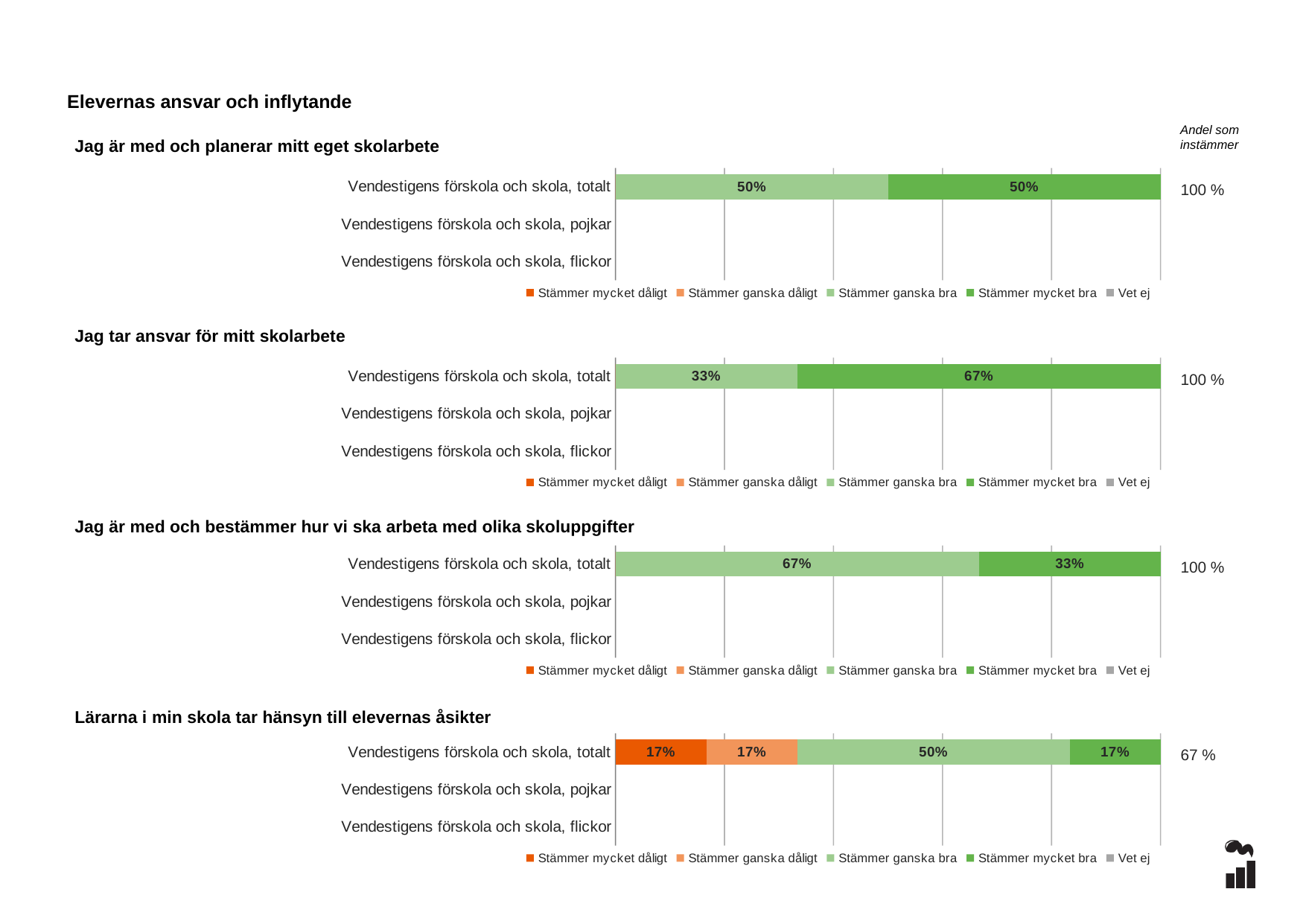
How many series does the legend list in the chart 'Jag tar ansvar för mitt skolarbete'? 5 In the chart 'Lärarna i min skola tar hänsyn till elevernas åsikter', which response category has the largest share for Vendestigens förskola och skola, totalt? Stämmer ganska bra In the chart 'Lärarna i min skola tar hänsyn till elevernas åsikter', what is the value for 'Stämmer mycket dåligt' for Vendestigens förskola och skola, totalt? 17% What is the 'Andel som instämmer' value shown for the chart 'Lärarna i min skola tar hänsyn till elevernas åsikter'? 67 % In the chart 'Lärarna i min skola tar hänsyn till elevernas åsikter', what is the total of 'Stämmer mycket dåligt' and 'Stämmer ganska dåligt' for Vendestigens förskola och skola, totalt? 34% In the chart 'Jag tar ansvar för mitt skolarbete', what is the value for 'Stämmer mycket bra' for Vendestigens förskola och skola, totalt? 67% What kind of chart is 'Lärarna i min skola tar hänsyn till elevernas åsikter'? Stacked bar chart In the chart 'Jag tar ansvar för mitt skolarbete', what is the difference between 'Stämmer mycket bra' and 'Stämmer ganska bra' for Vendestigens förskola och skola, totalt? 34% In the chart 'Jag är med och bestämmer hur vi ska arbeta med olika skoluppgifter', which is larger for Vendestigens förskola och skola, totalt: 'Stämmer ganska bra' or 'Stämmer mycket bra'? Stämmer ganska bra How many categories are listed on the y axis of the chart 'Jag är med och planerar mitt eget skolarbete'? 3 In the chart 'Jag är med och bestämmer hur vi ska arbeta med olika skoluppgifter', what is the value for 'Stämmer ganska bra' for Vendestigens förskola och skola, totalt? 67% In the chart 'Jag är med och planerar mitt eget skolarbete', what is the value for 'Stämmer ganska bra' for Vendestigens förskola och skola, totalt? 50%